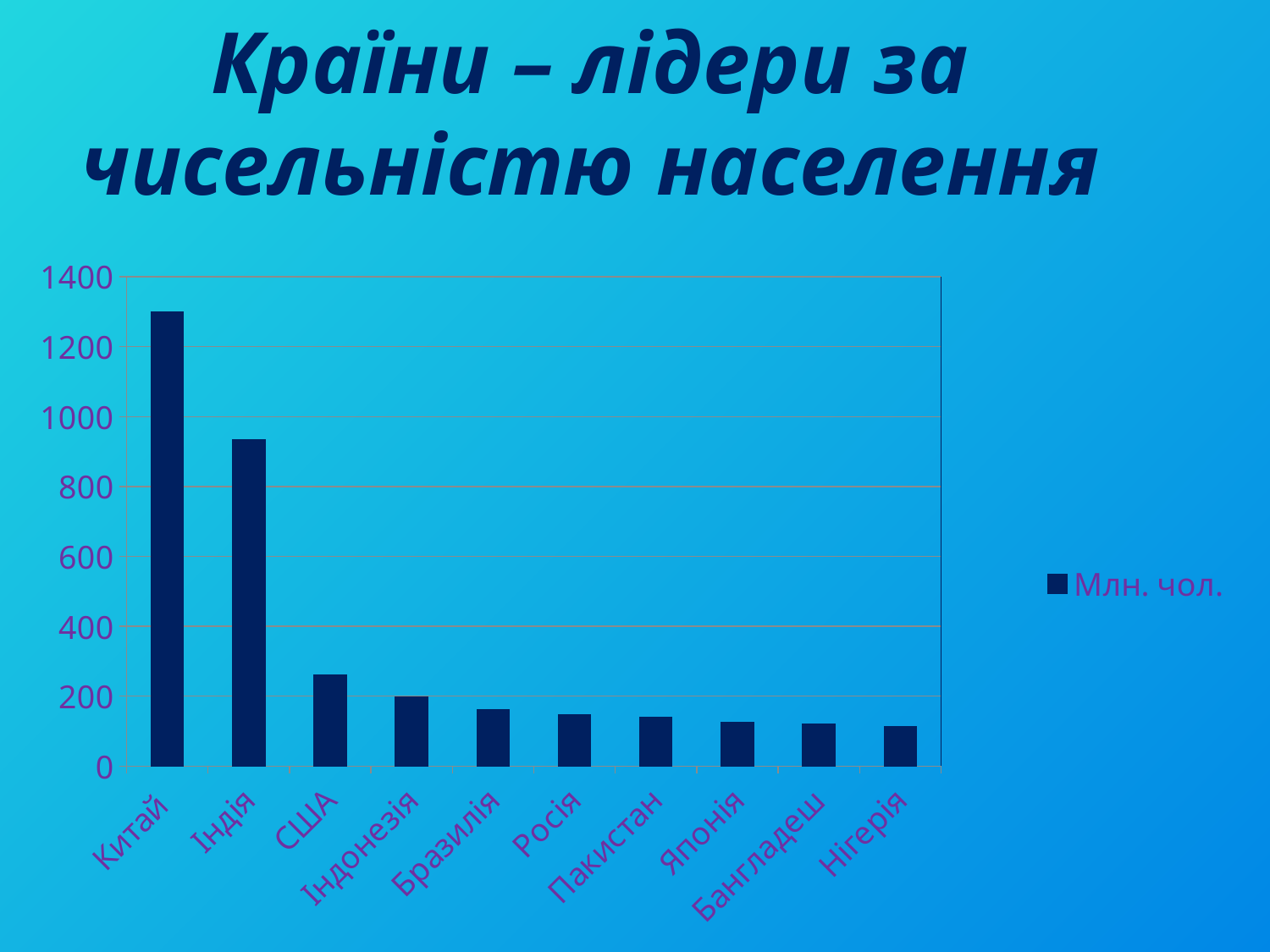
Which country has the highest value in the chart? Китай Is the value for Нігерія greater or less than 200? less Do the values rise or fall from left to right along the x axis? fall Is the value for Бразилія greater or less than 200? less Is the value for США greater or less than 200? greater What is the legend entry of the chart? Млн. чол. How many countries are shown on the x axis of the chart? 10 Which has a larger value, Китай or Індія? Китай What kind of chart is shown on the slide? bar chart How many series does the legend list? 1